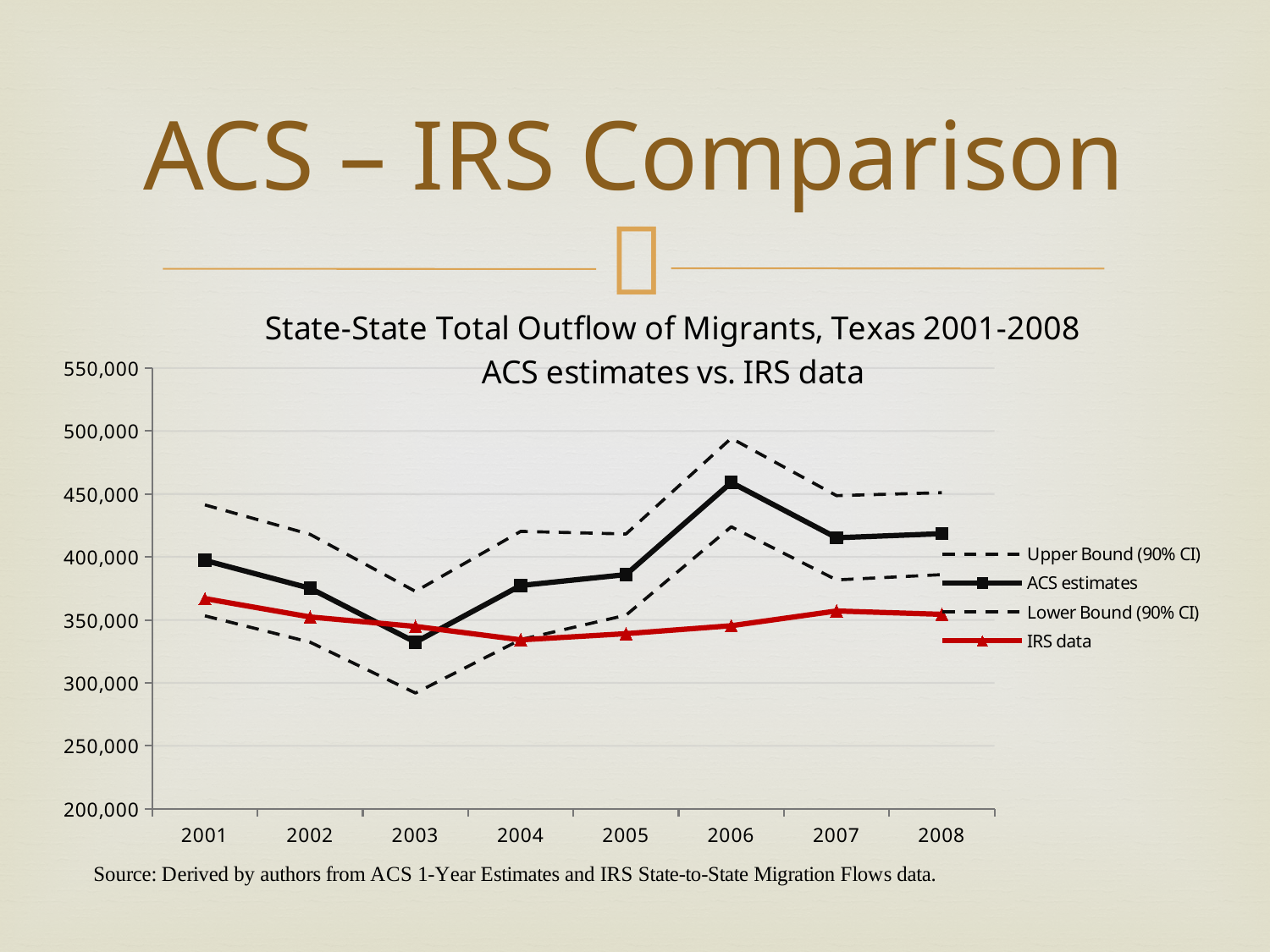
Is the ACS estimates value for 2003 greater or less than 350,000? less Is the ACS estimates value for 2006 greater or less than 450,000? greater In 2006, which is larger: the ACS estimates value or the IRS data value? ACS estimates Is the Upper Bound (90% CI) value for 2006 greater or less than 500,000? less What is the title of the chart? State-State Total Outflow of Migrants, Texas 2001-2008 ACS estimates vs. IRS data How many series does the legend list? 4 How many years are plotted along the x axis? 8 What kind of chart is shown on the slide? line chart Does the ACS estimates series rise or fall from 2003 to 2006? rise In which year is the ACS estimates series at its highest? 2006 In which year is the ACS estimates series at its lowest? 2003